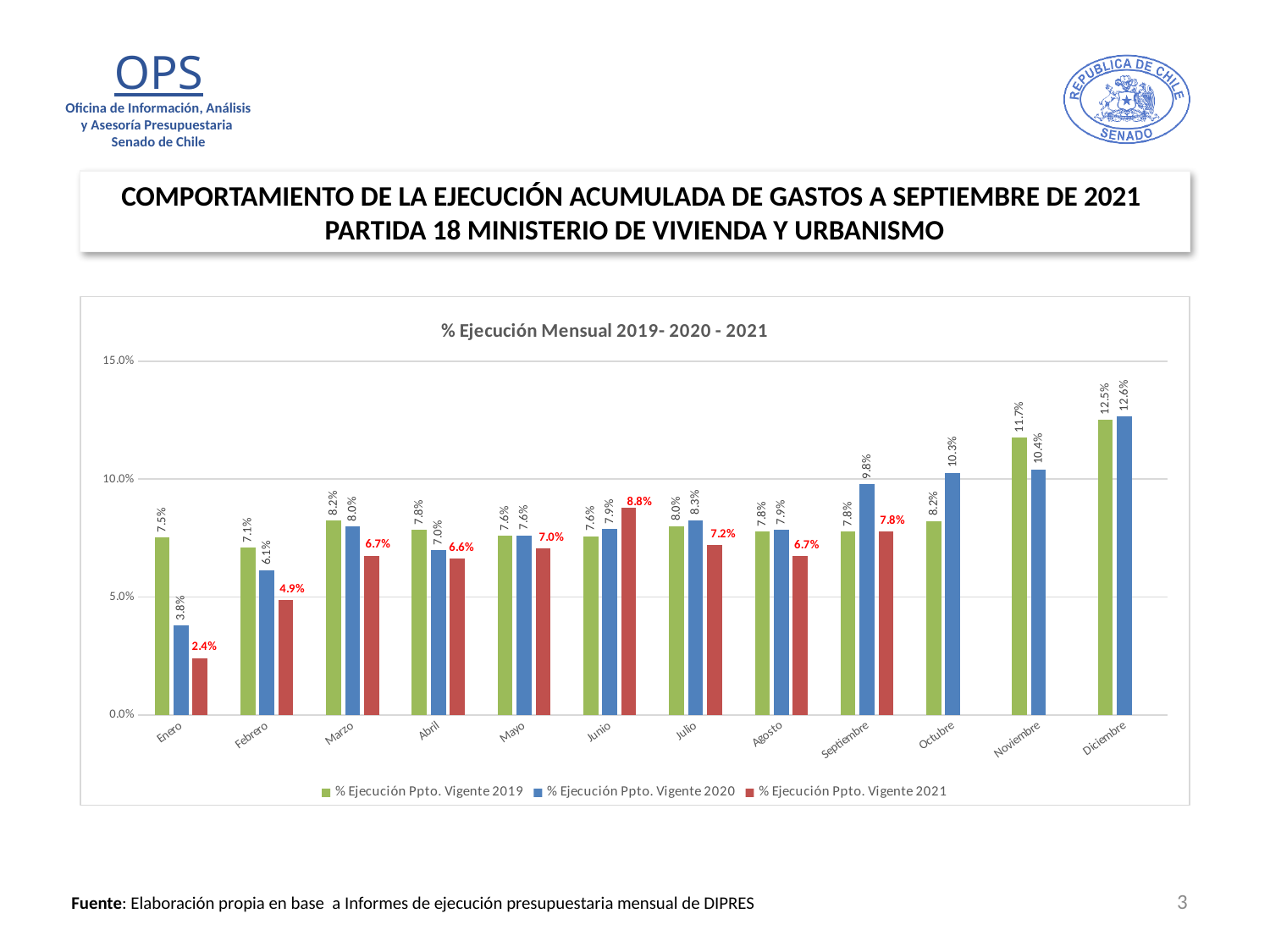
What is the value for % Ejecución Ppto. Vigente 2020 in Septiembre? 9.8% How many months are shown on the x axis? 12 What is the difference between the 2019 and 2021 values in Enero? 5.1% In Junio, which is larger: the 2019 value or the 2021 value? 2021 value What is the value for % Ejecución Ppto. Vigente 2021 in Enero? 2.4% Which month has the highest value for % Ejecución Ppto. Vigente 2021? Junio What kind of chart is shown on the slide? Bar chart Which month has the lowest value for % Ejecución Ppto. Vigente 2020? Enero What is the title of the chart? % Ejecución Mensual 2019- 2020 - 2021 What is the value for % Ejecución Ppto. Vigente 2019 in Noviembre? 11.7% Is the value for % Ejecución Ppto. Vigente 2020 in Diciembre greater or less than 10.0%? greater How many series does the legend list? 3